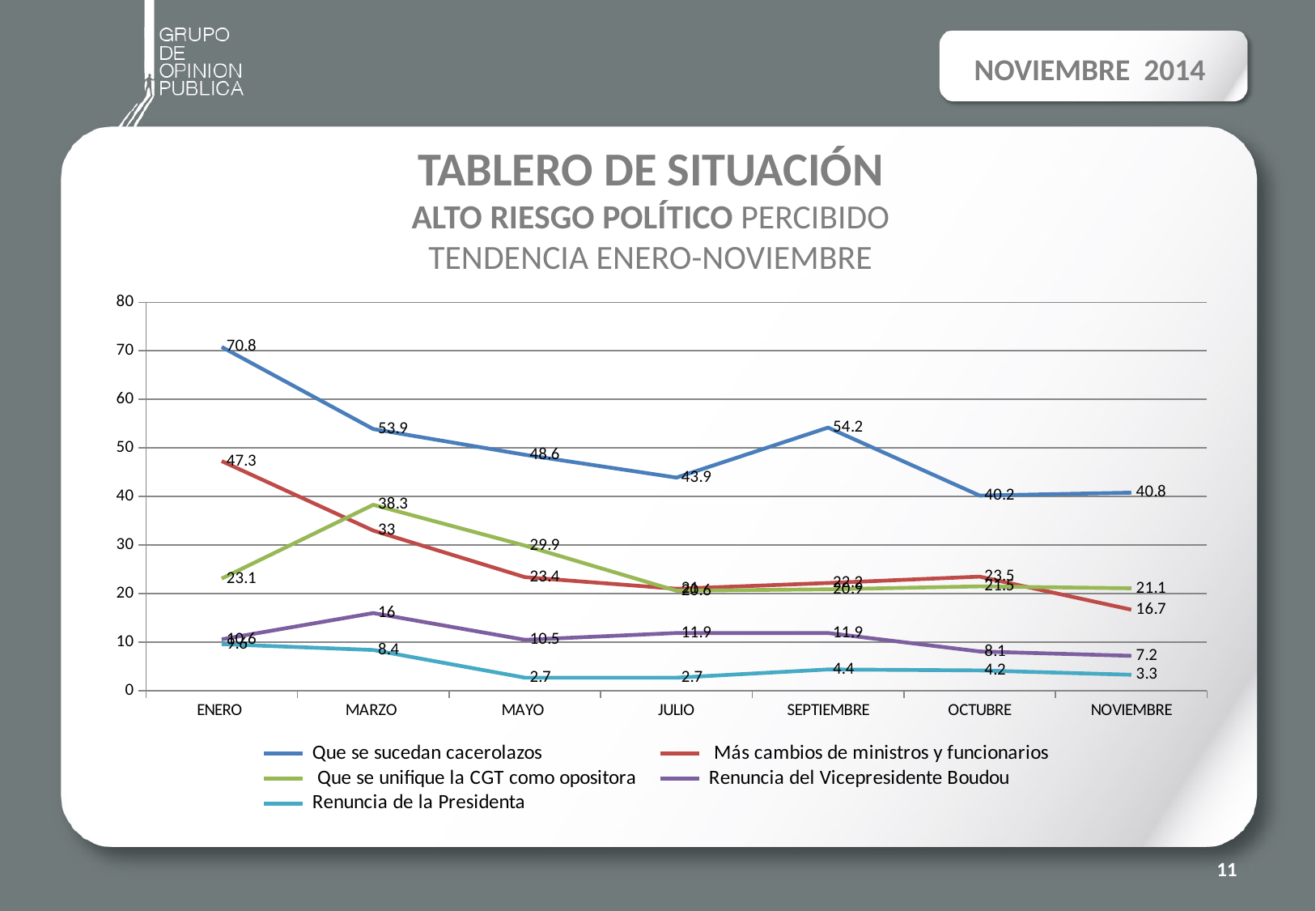
What kind of chart is shown on the slide? line chart In which month does Que se sucedan cacerolazos reach its highest value? ENERO How many series does the legend list? 5 What is the difference between the ENERO and NOVIEMBRE values for Que se sucedan cacerolazos? 30 What is the value for Renuncia de la Presidenta in MAYO? 2.7 What is the value for Que se sucedan cacerolazos in ENERO? 70.8 In which month does Que se unifique la CGT como opositora reach its highest value? MARZO What is the value for Renuncia del Vicepresidente Boudou in MARZO? 16 Is the value for Que se sucedan cacerolazos in SEPTIEMBRE greater or less than 50? greater What is the value for Que se unifique la CGT como opositora in MARZO? 38.3 What is the value for Más cambios de ministros y funcionarios in NOVIEMBRE? 16.7 In MARZO, which is larger: Más cambios de ministros y funcionarios or Que se unifique la CGT como opositora? Que se unifique la CGT como opositora